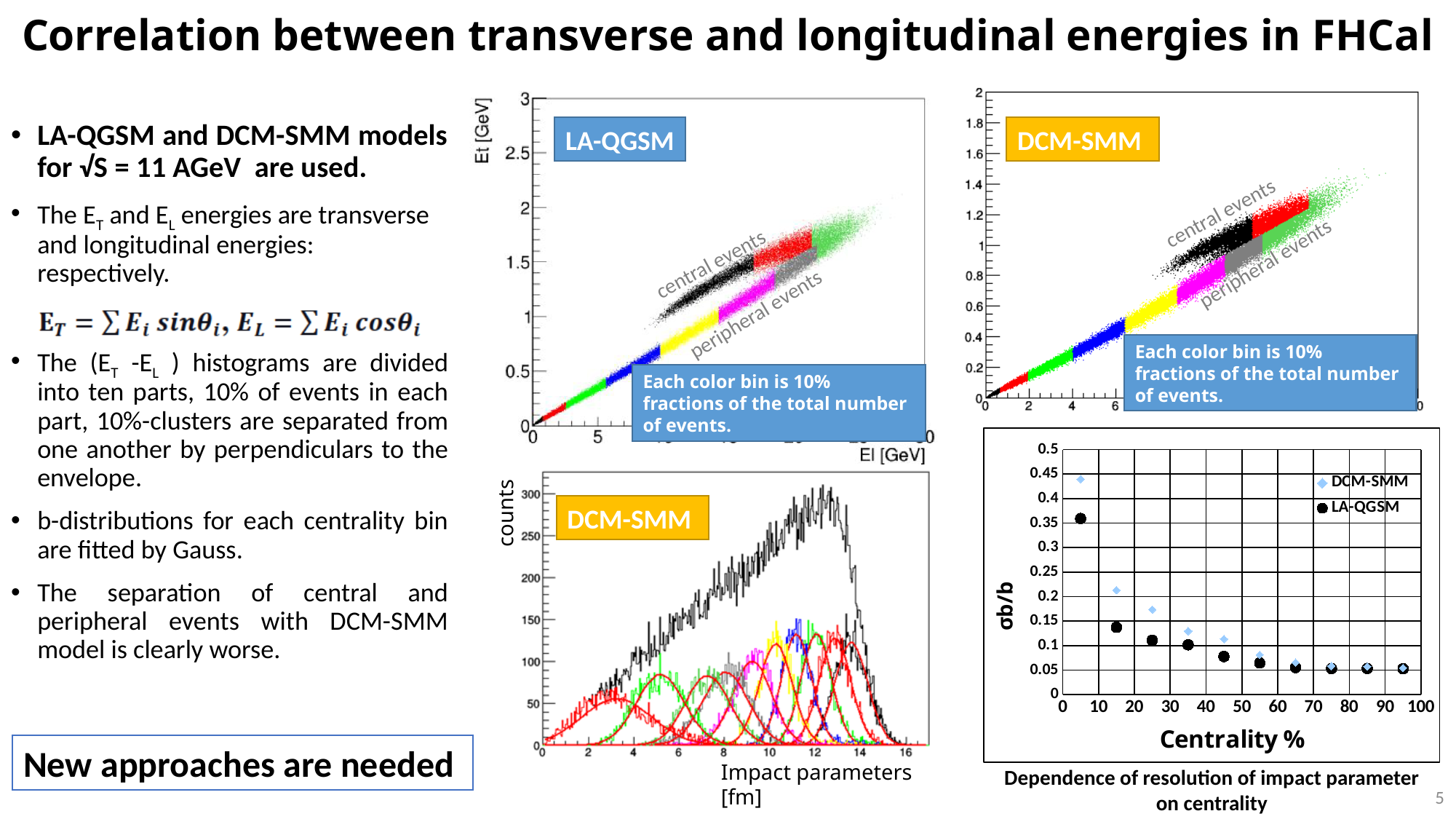
On the bottom-middle chart labelled DCM-SMM, what is the label of the x axis? Impact parameters [fm] What kind of chart is the bottom-right chart (Dependence of resolution of impact parameter on centrality)? scatter chart On the bottom-right chart (Dependence of resolution of impact parameter on centrality), is the DCM-SMM value at the lowest centrality greater or less than 0.4? greater On the bottom-right chart (Dependence of resolution of impact parameter on centrality), how many series does the legend list? 2 On the bottom-right chart (Dependence of resolution of impact parameter on centrality), which series has the higher σb/b at the lowest centrality, DCM-SMM or LA-QGSM? DCM-SMM On the bottom-right chart (Dependence of resolution of impact parameter on centrality), do the σb/b values rise or fall as centrality increases? fall On the bottom-right chart (Dependence of resolution of impact parameter on centrality), what are the two series named in the legend? DCM-SMM and LA-QGSM On the bottom-right chart (Dependence of resolution of impact parameter on centrality), what is the label of the x axis? Centrality % What kind of chart is the top-middle chart labelled LA-QGSM? scatter chart On the bottom-right chart (Dependence of resolution of impact parameter on centrality), is the LA-QGSM value at the lowest centrality greater or less than 0.4? less On the bottom-right chart (Dependence of resolution of impact parameter on centrality), is the LA-QGSM value at the lowest centrality greater or less than 0.3? greater